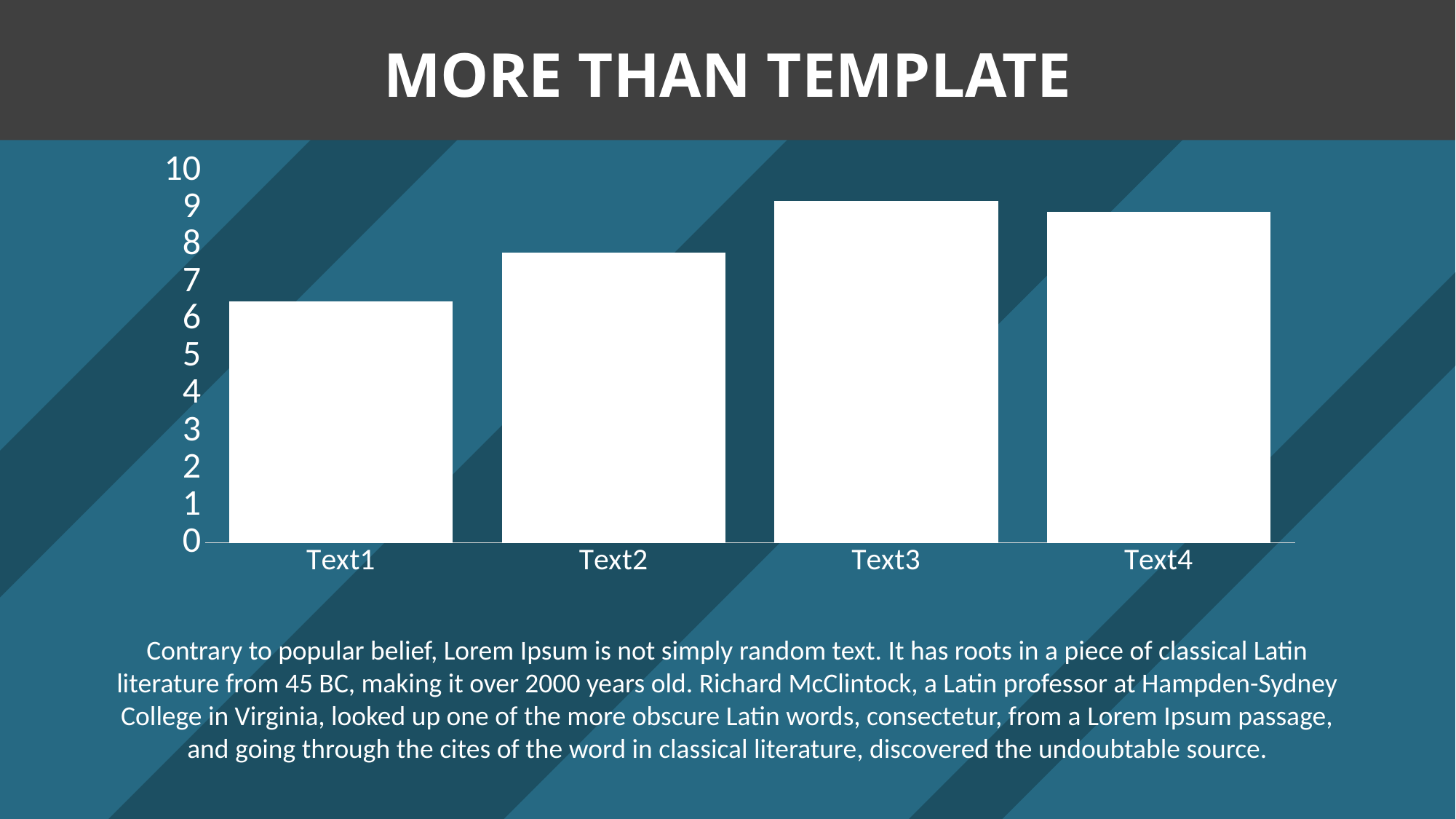
Is the value for Text3 greater or less than 8? greater How many categories are plotted on the x axis of the chart? 4 Is the value for Text1 greater or less than 5? greater Is the value for Text2 greater or less than 7? greater What kind of chart is shown on the slide? bar chart Which is larger, the value for Text2 or the value for Text3? Text3 Which is larger, the value for Text1 or the value for Text2? Text2 What is the title shown above the chart on the slide? MORE THAN TEMPLATE Which category has the lowest bar in the chart? Text1 Which is larger, the value for Text1 or the value for Text4? Text4